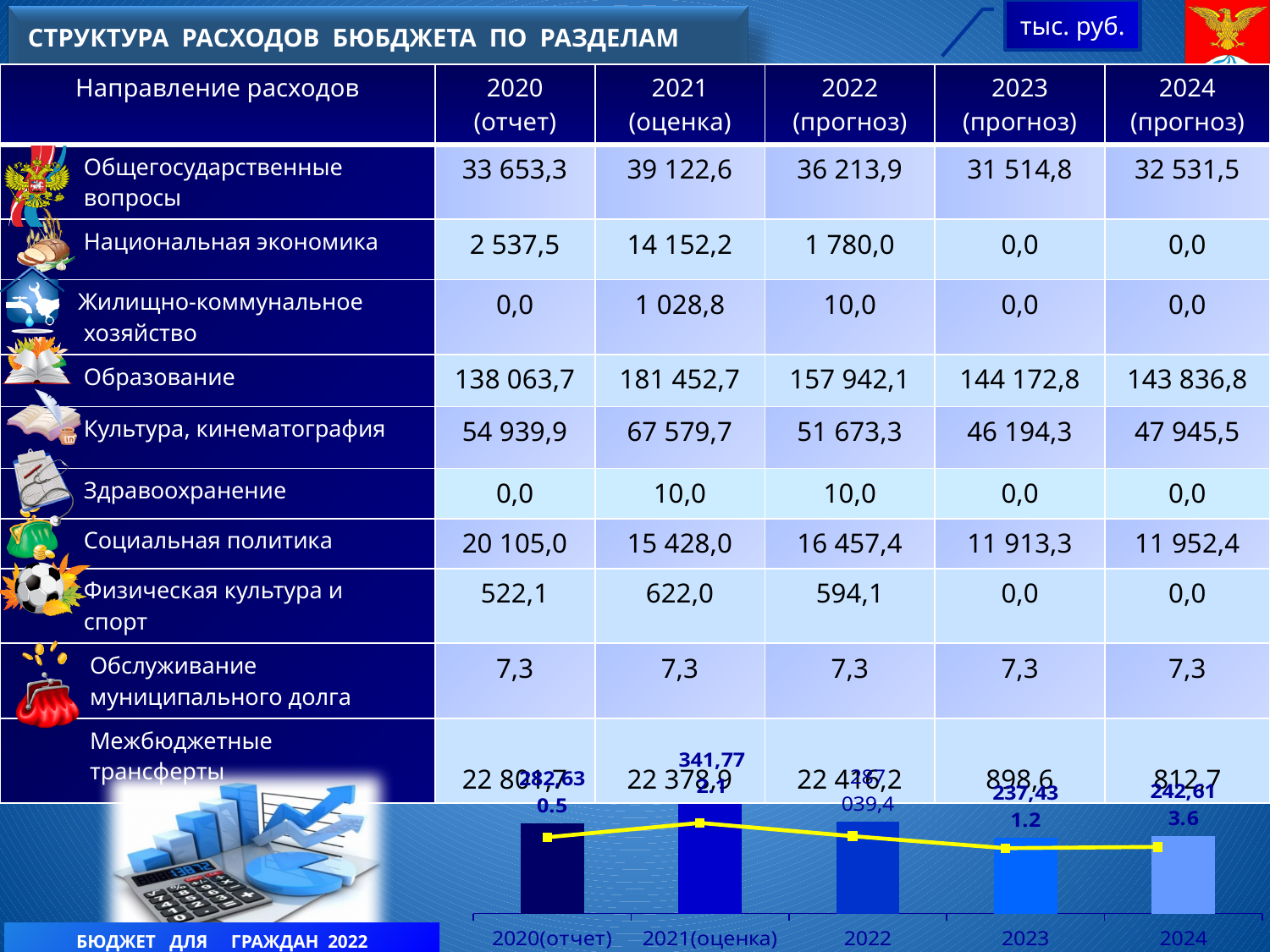
In the chart at the bottom of the slide, what is the bar value for 2020(отчет)? 282,630.5 In the chart at the bottom of the slide, which year has the highest bar? 2021(оценка) What kind of chart is shown at the bottom of the slide? A bar chart with a line overlaid In the chart at the bottom of the slide, which year has the lowest bar? 2023 In the chart at the bottom of the slide, what is the difference between the bar values for 2021(оценка) and 2020(отчет)? 59,141.6 In the chart at the bottom of the slide, do the bar values rise or fall from 2021(оценка) to 2023? Fall In the chart at the bottom of the slide, what is the bar value for 2024? 242,613.6 In the chart at the bottom of the slide, what is the bar value for 2021(оценка)? 341,772.1 In the chart at the bottom of the slide, which bar is taller: 2023 or 2024? 2024 How many categories are shown on the x axis of the chart at the bottom of the slide? 5 In the chart at the bottom of the slide, what is the bar value for 2023? 237,431.2